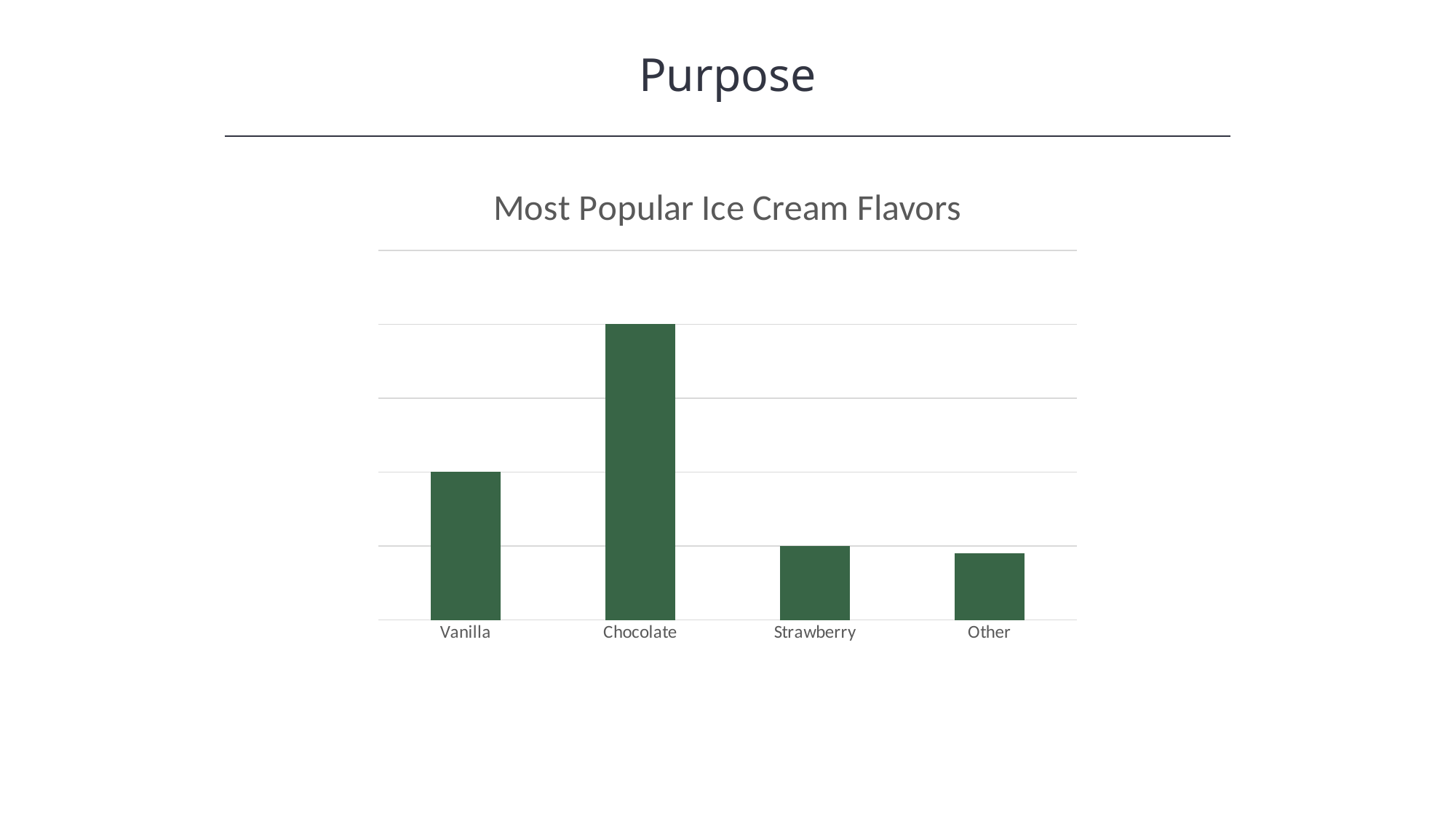
Which has the larger value, Vanilla or Other? Vanilla What is the title of the chart? Most Popular Ice Cream Flavors Which has the larger value, Vanilla or Strawberry? Vanilla Which has the larger value, Chocolate or Other? Chocolate Which flavor has the highest bar in the chart? Chocolate What kind of chart is shown on the slide? bar chart How many ice cream flavor categories are plotted in the chart? 4 What colour are the bars in the chart? dark green